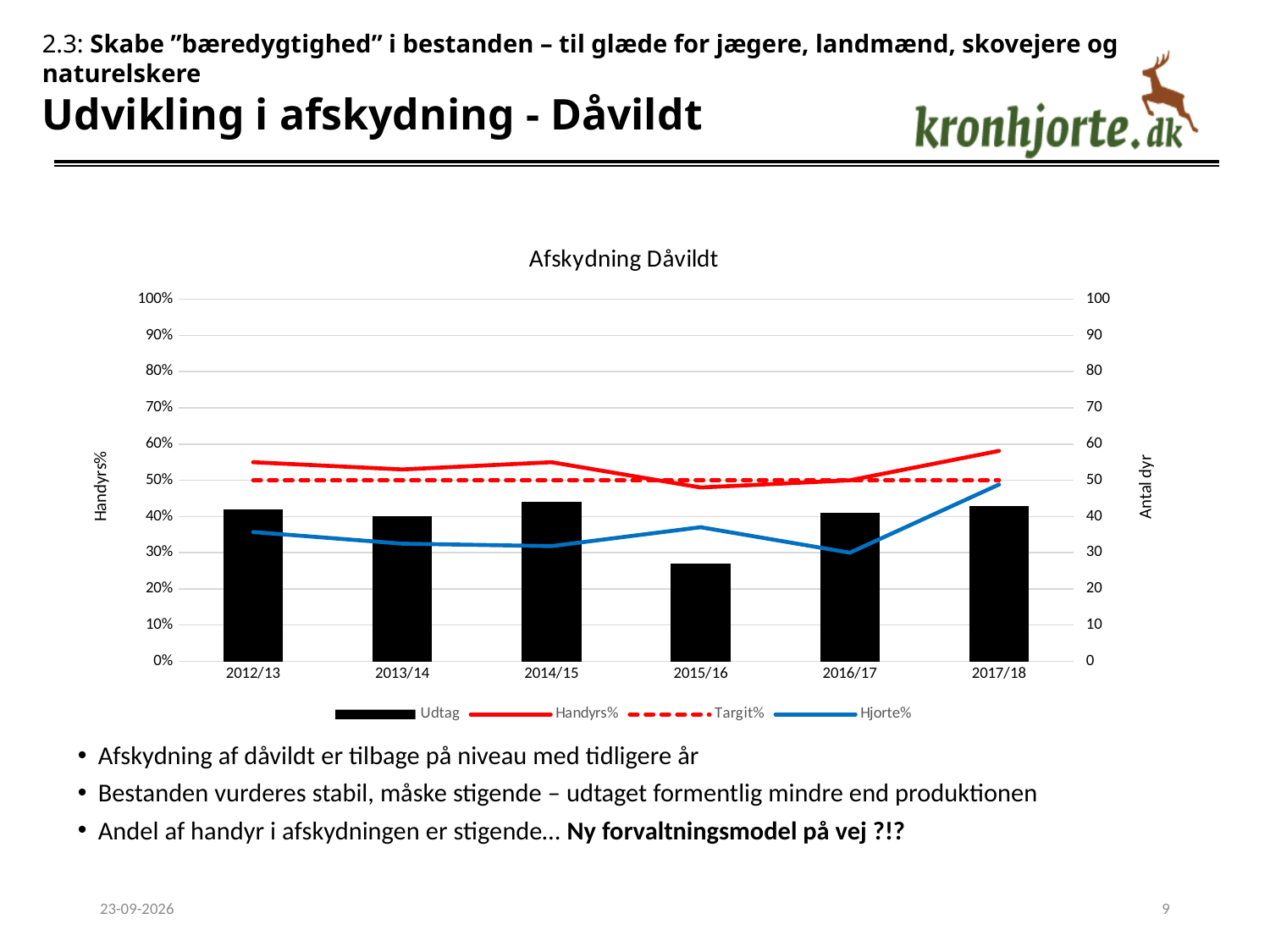
Is the Udtag value for 2015/16 greater or less than 30? less What kind of chart is shown on the slide? Combined bar and line chart Does the Handyrs% line rise or fall from 2015/16 to 2017/18? rise Is the Handyrs% value for 2017/18 greater or less than 50%? greater How many seasons (categories) are shown on the x axis of the chart? 6 At what level does the dashed Targit% line run across the chart? 50% Is the Hjorte% value for 2016/17 greater or less than 40%? less What is the title of the chart? Afskydning Dåvildt In 2012/13, which is higher: Handyrs% or Hjorte%? Handyrs% Which season has the lowest Udtag bar? 2015/16 How many series does the chart legend list? 4